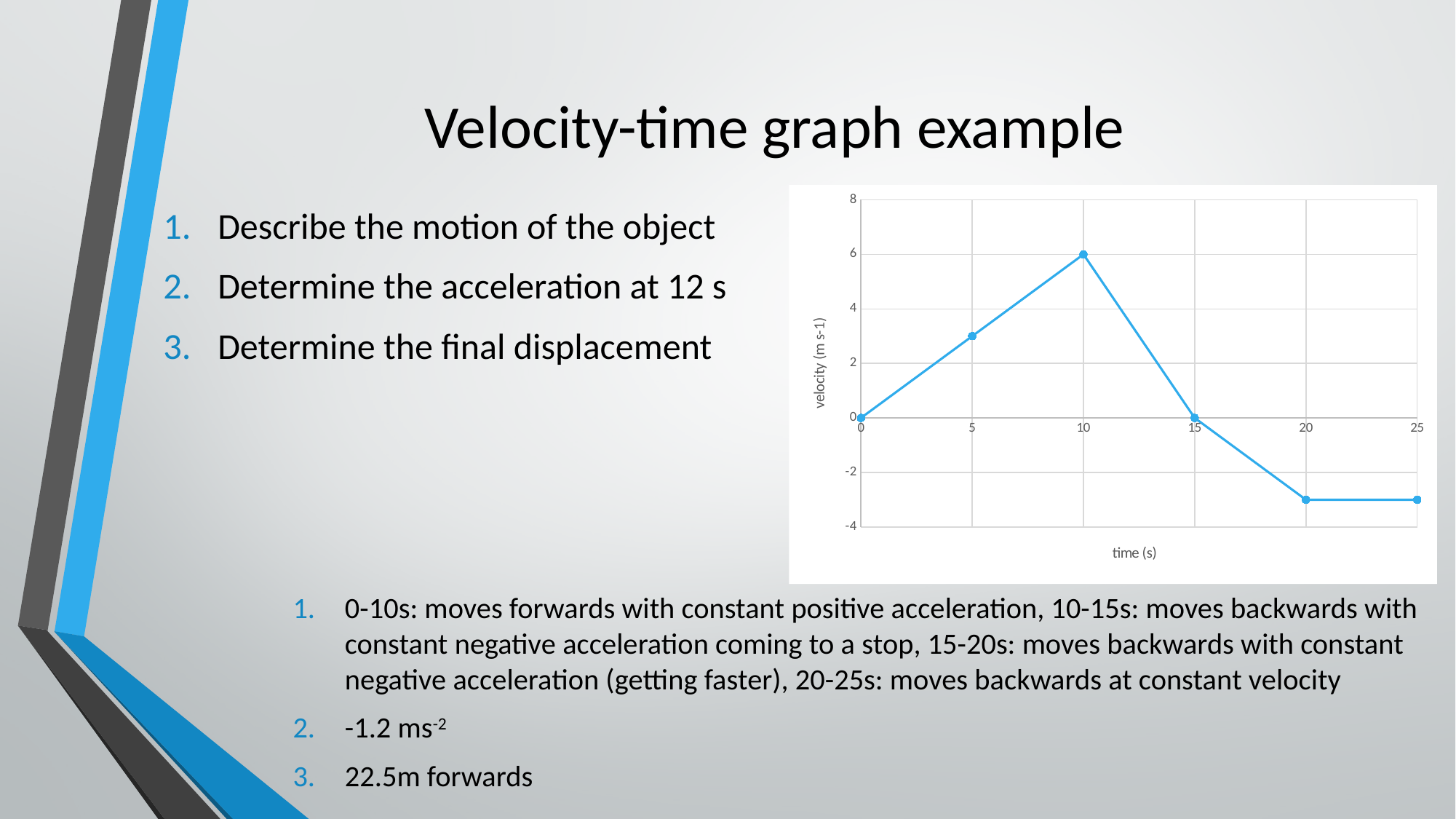
What is the velocity at 0 s? 0 What is the velocity at 15 s? 0 Does the velocity rise or fall between 10 s and 20 s? fall Is the velocity at 5 s greater or less than 2? greater What is the difference between the velocity at 10 s and the velocity at 15 s? 6 Is the velocity at 25 s greater or less than -4? greater What is the velocity at 10 s? 6 How many data points are plotted on the chart? 6 Is the velocity at 20 s greater or less than -2? less What type of chart is shown on the slide? line chart Which is larger, the velocity at 5 s or the velocity at 10 s? 10 s At what time is the velocity highest? 10 s